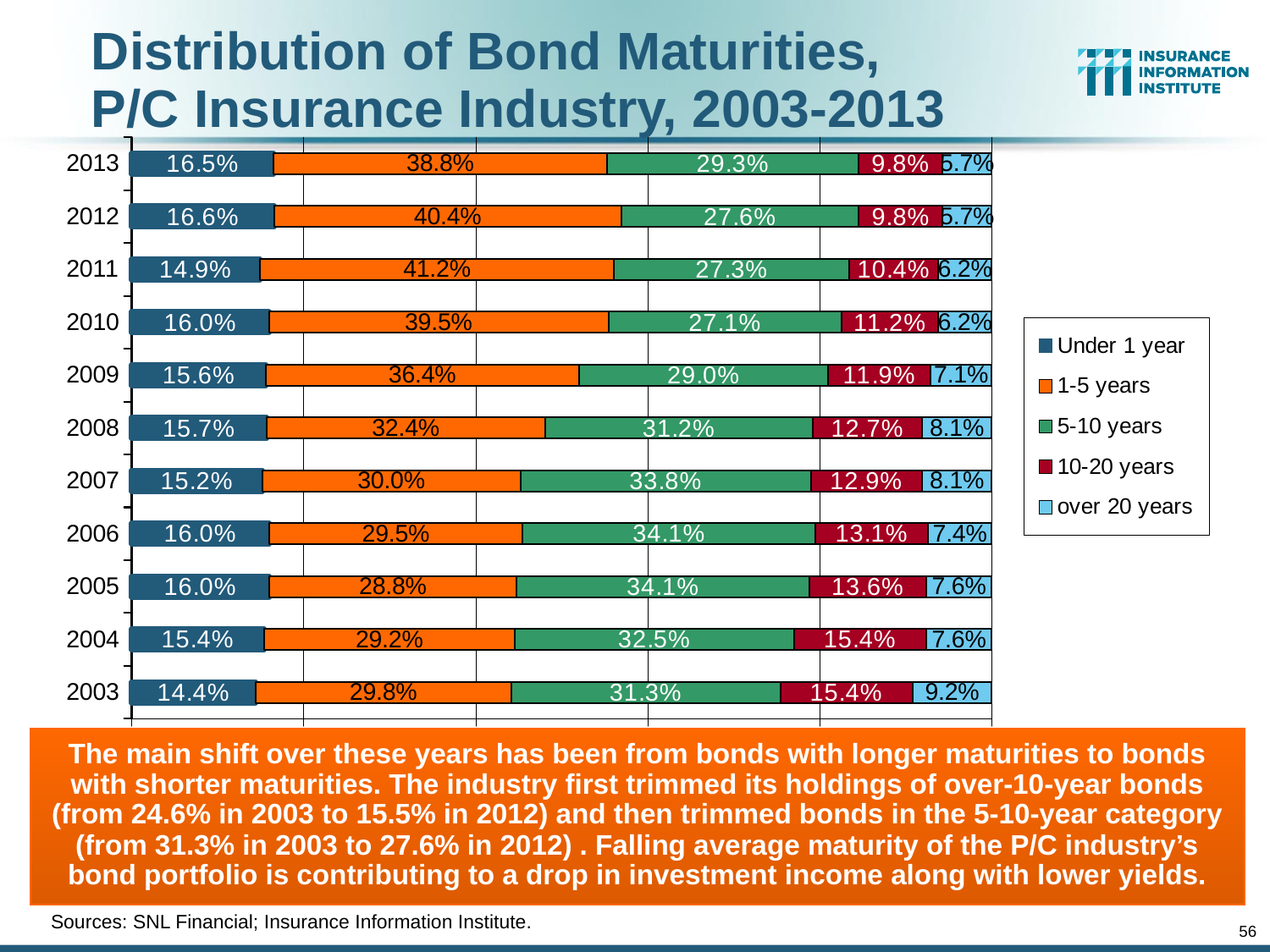
What kind of chart is shown on the slide? Stacked bar chart In which year was the 1-5 years share the highest? 2011 What share of bonds had a 10-20 year maturity in 2003? 15.4% In which year was the Under 1 year share the lowest? 2003 Which was larger in 2009: the 1-5 years share or the 5-10 years share? 1-5 years What share of bonds had a 5-10 year maturity in 2007? 33.8% Did the 10-20 years share rise or fall from 2003 to 2013? Fall In which year was the over 20 years share the highest? 2003 What is the difference between the 1-5 years share in 2013 and in 2003? 9.0 percentage points How many years are shown on the chart? 11 What share of bonds had a 1-5 year maturity in 2013? 38.8% How many series does the legend list? 5